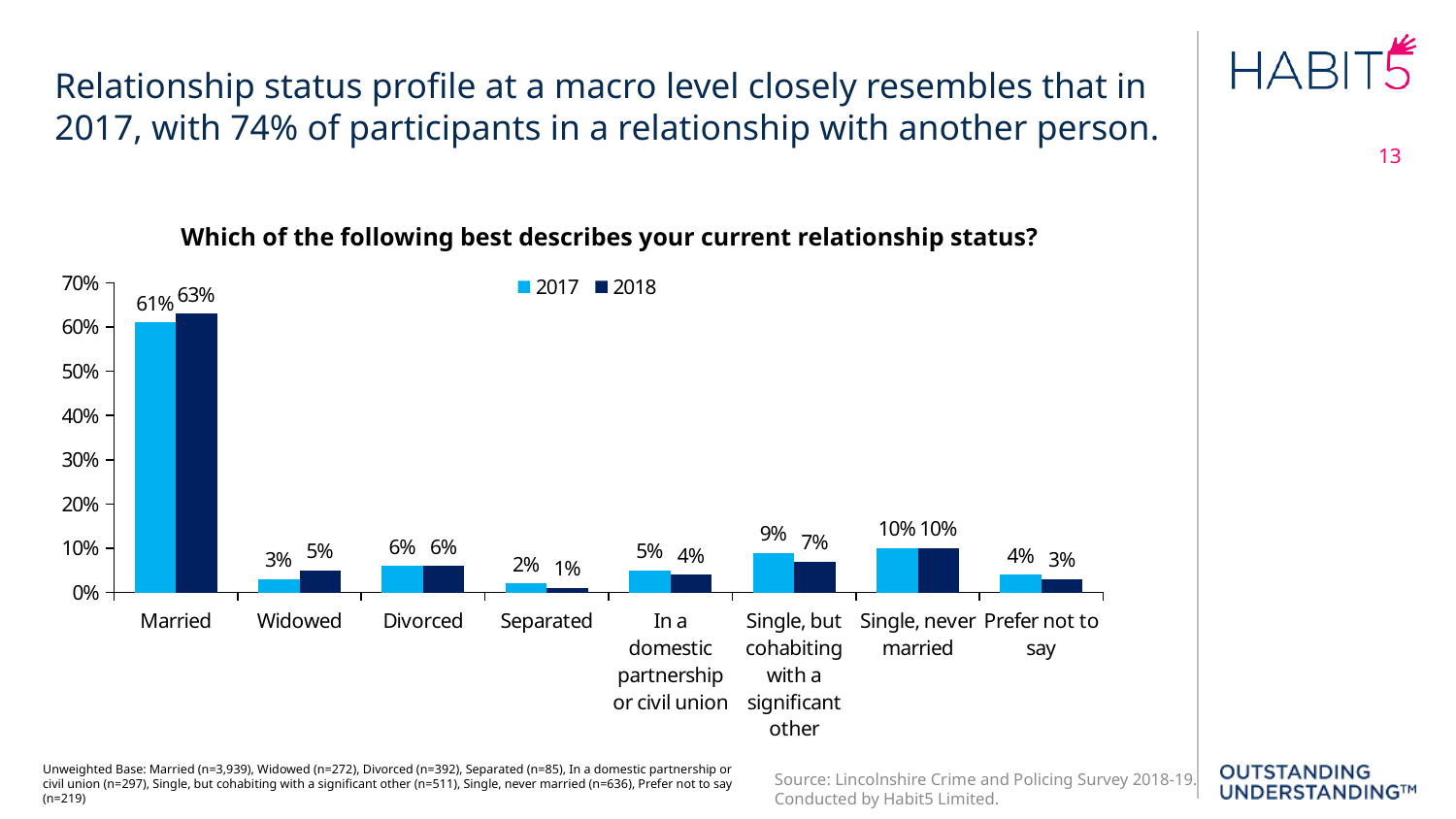
Is the 2017 value for Married greater or less than 50%? greater How many relationship status categories are shown on the x axis? 8 What percentage of participants were Married in 2018? 63% Which is larger for Single, but cohabiting with a significant other: the 2017 value or the 2018 value? 2017 What was the value for Widowed in 2017? 3% What is the difference between the 2018 and 2017 values for Married? 2% What percentage of participants were Single, never married in 2017? 10% What is the title of the chart? Which of the following best describes your current relationship status? Which category has the lowest value in 2018? Separated Which relationship status category has the highest value in 2018? Married What type of chart is shown on the slide? Bar chart How many series does the legend list? 2